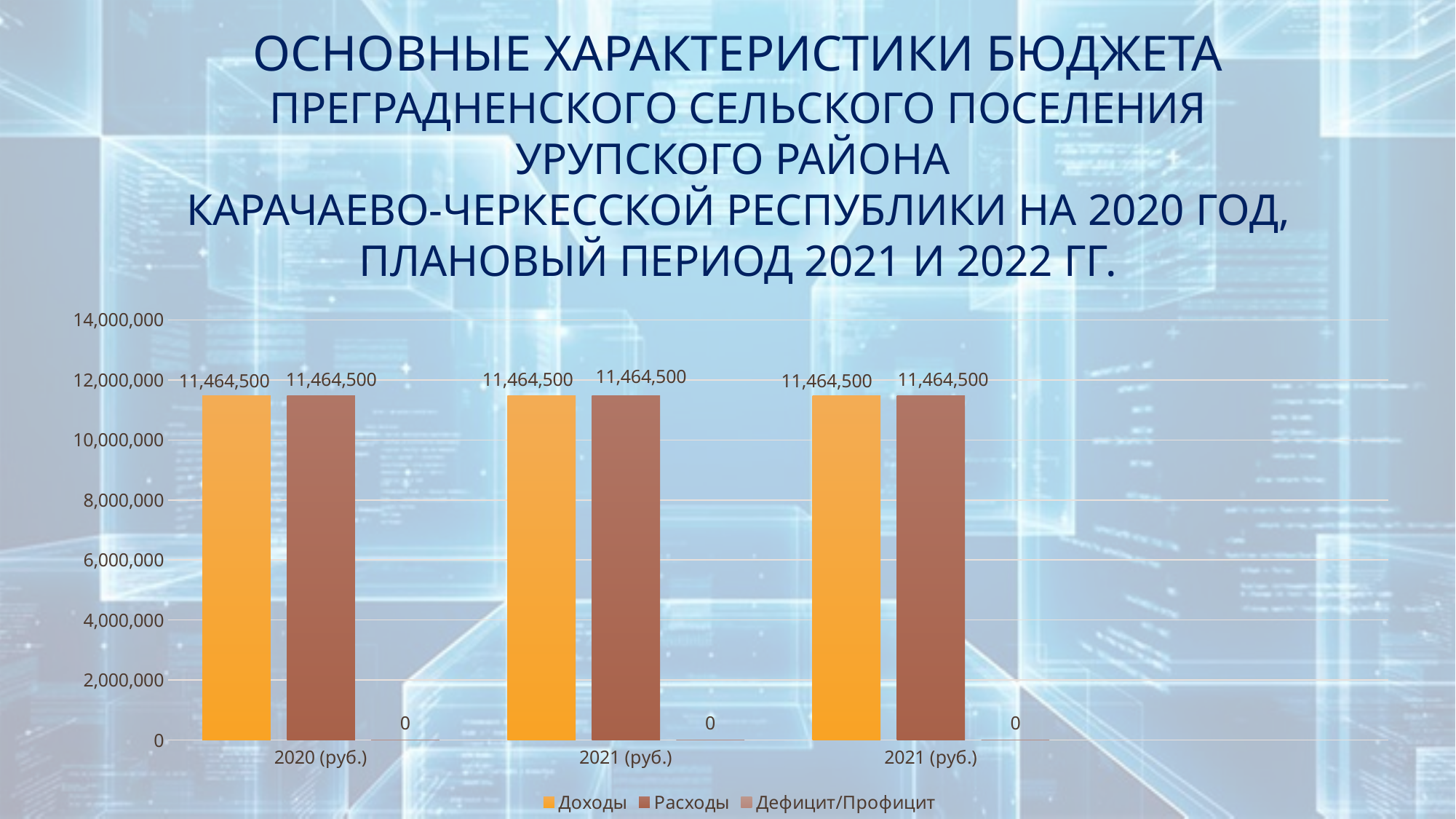
What is the value of Расходы for 2020 (руб.)? 11,464,500 What are the three series listed in the chart legend? Доходы, Расходы, Дефицит/Профицит What is the value of Доходы in the middle category of the chart? 11,464,500 Is the value of Доходы for 2020 (руб.) greater or less than 10,000,000? greater How many series does the chart legend list? 3 How many categories are shown along the x axis of the chart? 3 What is the value of Дефицит/Профицит in the rightmost category of the chart? 0 What is the difference between Доходы and Расходы for 2020 (руб.)? 0 What kind of chart is shown on the slide? bar chart What is the value of Дефицит/Профицит for 2020 (руб.)? 0 Which series has the lowest value in the 2020 (руб.) category? Дефицит/Профицит What is the value of Доходы for 2020 (руб.)? 11,464,500